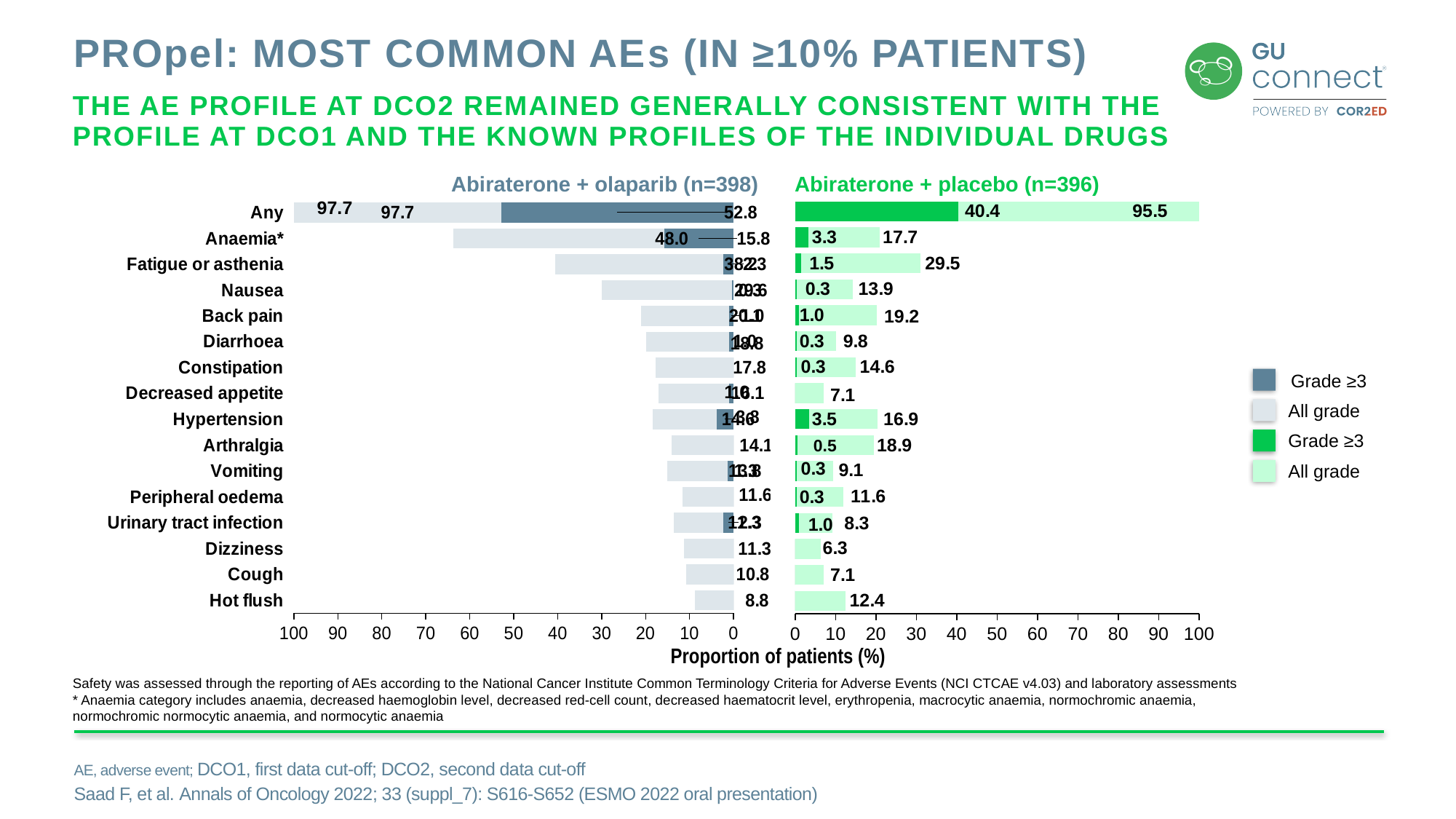
In the Abiraterone + placebo (n=396) chart, what is the Grade ≥3 value for Any? 40.4 In the Abiraterone + placebo (n=396) chart, which adverse event has the lowest all grade value? Dizziness In the Abiraterone + placebo (n=396) chart, what is the difference between the all grade and Grade ≥3 values for Any? 55.1 In the Abiraterone + placebo (n=396) chart, excluding Any, which adverse event has the highest all grade value? Fatigue or asthenia In the Abiraterone + olaparib (n=398) chart, what is the all grade value for Hot flush? 8.8 In the Abiraterone + placebo (n=396) chart, what is the all grade value for Any? 95.5 How many adverse event categories are listed on the y axis of the charts? 16 In the Abiraterone + olaparib (n=398) chart, what is the Grade ≥3 value for Anaemia*? 15.8 In the Abiraterone + placebo (n=396) chart, what is the all grade value for Fatigue or asthenia? 29.5 What kind of chart is used on this slide? Bar chart In the Abiraterone + placebo (n=396) chart, what is the Grade ≥3 value for Hypertension? 3.5 In the Abiraterone + olaparib (n=398) chart, what is the all grade value for Any? 97.7